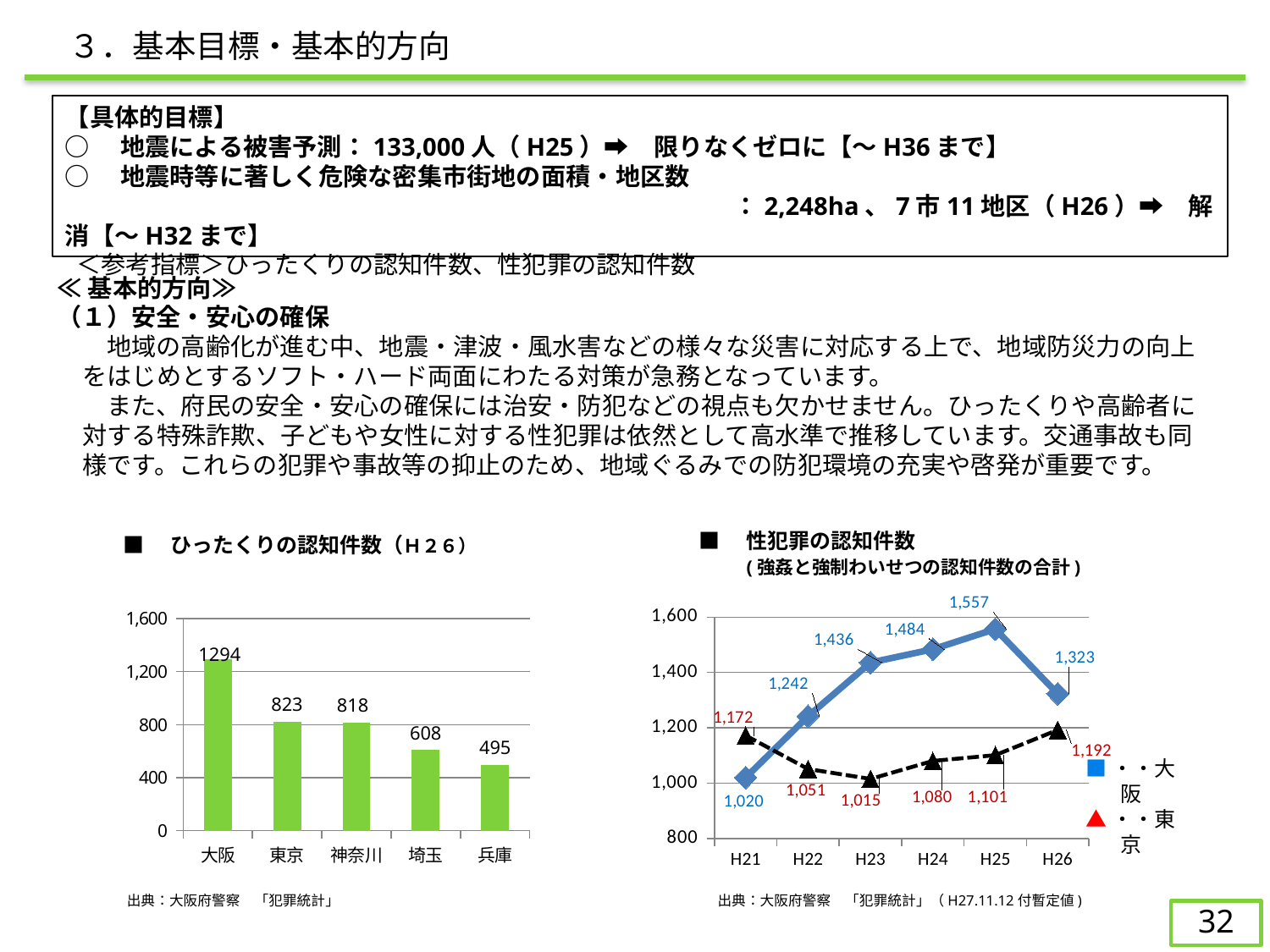
In the ひったくりの認知件数（H26） chart, how many prefectures are shown? 5 In the 性犯罪の認知件数 chart, which year has the highest value for 大阪? H25 In the 性犯罪の認知件数 chart, what is the value for 大阪 in H25? 1,557 In the ひったくりの認知件数（H26） chart, what is the difference between 東京 and 埼玉? 215 In the 性犯罪の認知件数 chart, what is the value for 東京 in H23? 1,015 In the 性犯罪の認知件数 chart, what is the difference between 大阪 and 東京 in H26? 131 In the 性犯罪の認知件数 chart, which is larger in H21, 大阪 or 東京? 東京 How many series does the legend of the 性犯罪の認知件数 chart list? 2 In the ひったくりの認知件数（H26） chart, which prefecture has the lowest value? 兵庫 What kind of chart is the ひったくりの認知件数（H26） chart? bar chart In the ひったくりの認知件数（H26） chart, is the value for 神奈川 greater or less than 800? greater In the ひったくりの認知件数（H26） chart, what is the value for 大阪? 1294